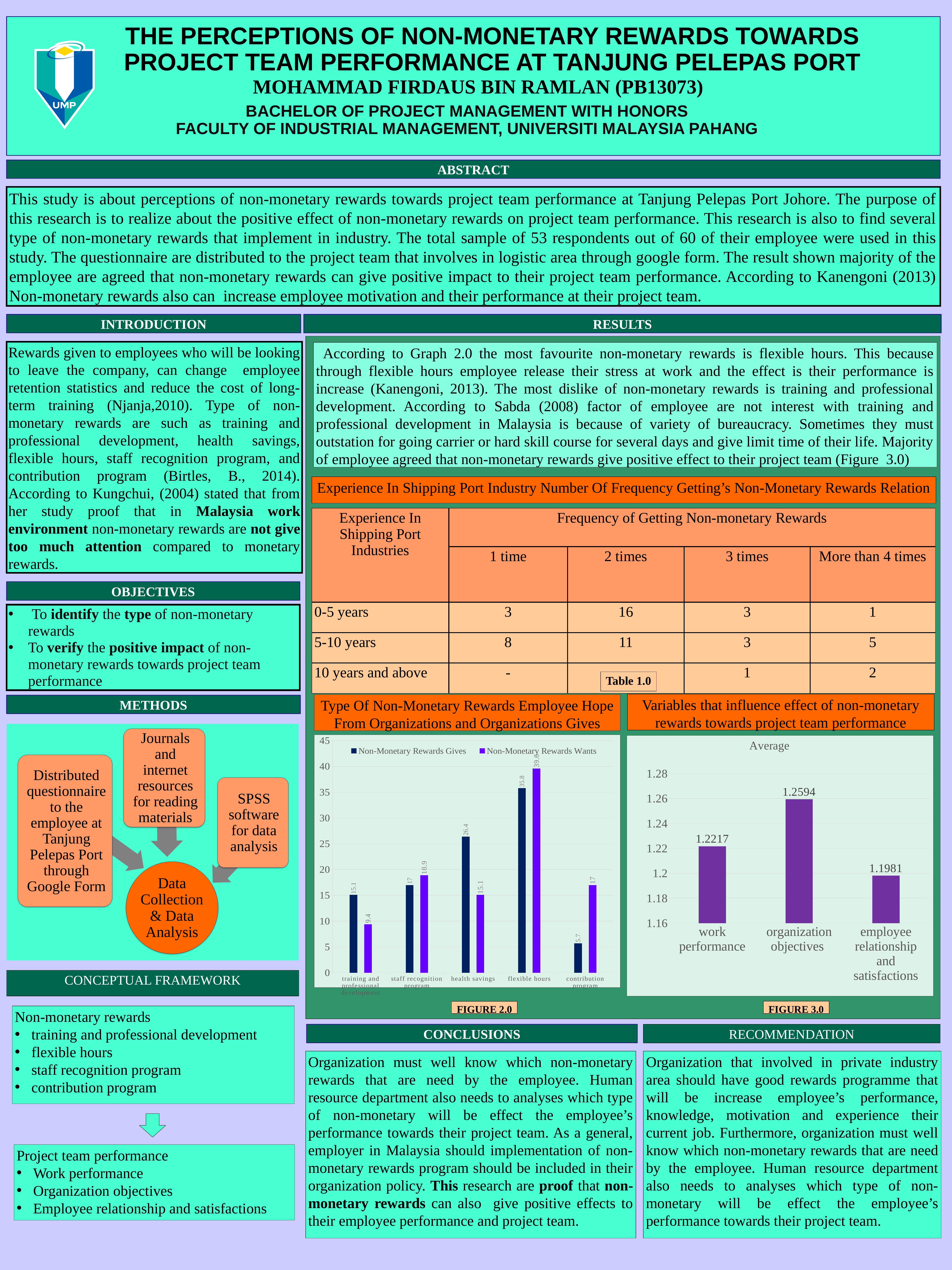
In the Figure 2.0 chart (Type Of Non-Monetary Rewards), which is larger for staff recognition program: Non-Monetary Rewards Gives or Non-Monetary Rewards Wants? Non-Monetary Rewards Wants How many categories are shown on the x axis of the Figure 2.0 chart (Type Of Non-Monetary Rewards)? 5 In the Figure 2.0 chart (Type Of Non-Monetary Rewards), what is the Non-Monetary Rewards Gives value for health savings? 26.4 In the Figure 2.0 chart (Type Of Non-Monetary Rewards), what is the difference between the Gives and Wants values for contribution program? 11.3 How many series does the legend of the Figure 2.0 chart (Type Of Non-Monetary Rewards) list? 2 In the Figure 2.0 chart (Type Of Non-Monetary Rewards), which category has the highest Non-Monetary Rewards Gives value? flexible hours In the Figure 3.0 chart (Variables that influence effect of non-monetary rewards), what is the average value for organization objectives? 1.2594 In the Figure 2.0 chart (Type Of Non-Monetary Rewards), which category has the lowest Non-Monetary Rewards Wants value? training and professional development In the Figure 2.0 chart (Type Of Non-Monetary Rewards), what is the Non-Monetary Rewards Wants value for flexible hours? 39.6 In the Figure 3.0 chart (Variables that influence effect of non-monetary rewards), which variable has the lowest average? employee relationship and satisfactions In the Figure 3.0 chart (Variables that influence effect of non-monetary rewards), what is the difference between the averages for organization objectives and work performance? 0.0377 What kind of chart is Figure 3.0 (Variables that influence effect of non-monetary rewards)? bar chart